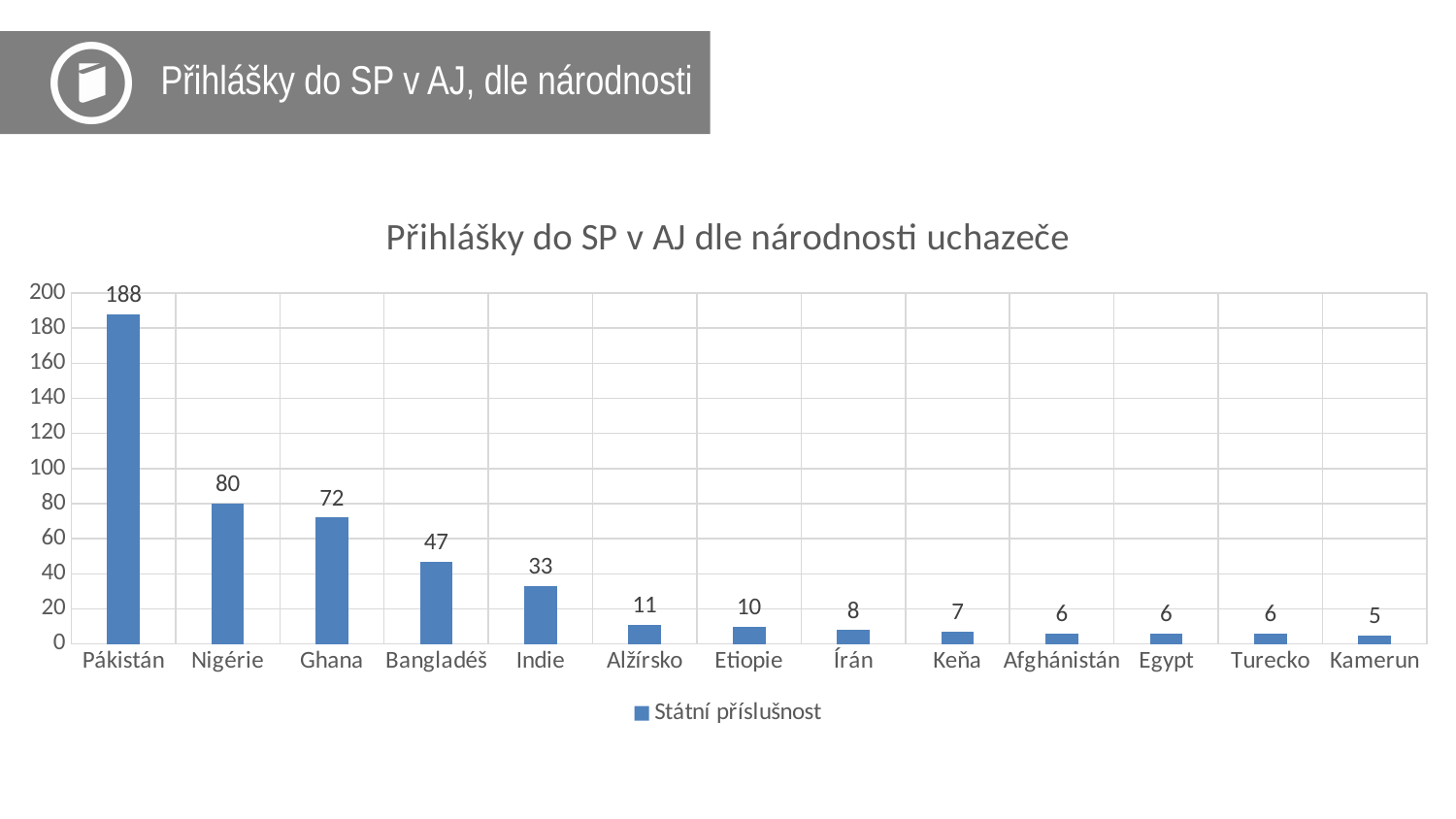
What is the value for Pákistán? 188 What is the difference between the values for Nigérie and Ghana? 8 How many countries are shown on the x axis? 13 Which has a larger value, Alžírsko or Etiopie? Alžírsko How many series does the legend list? 1 What is the title of the chart? Přihlášky do SP v AJ dle národnosti uchazeče What is the value for Bangladéš? 47 Which country has the highest value? Pákistán What kind of chart is shown? bar chart Is the value for Pákistán greater or less than 180? greater Which country has the lowest value? Kamerun What is the value for Indie? 33